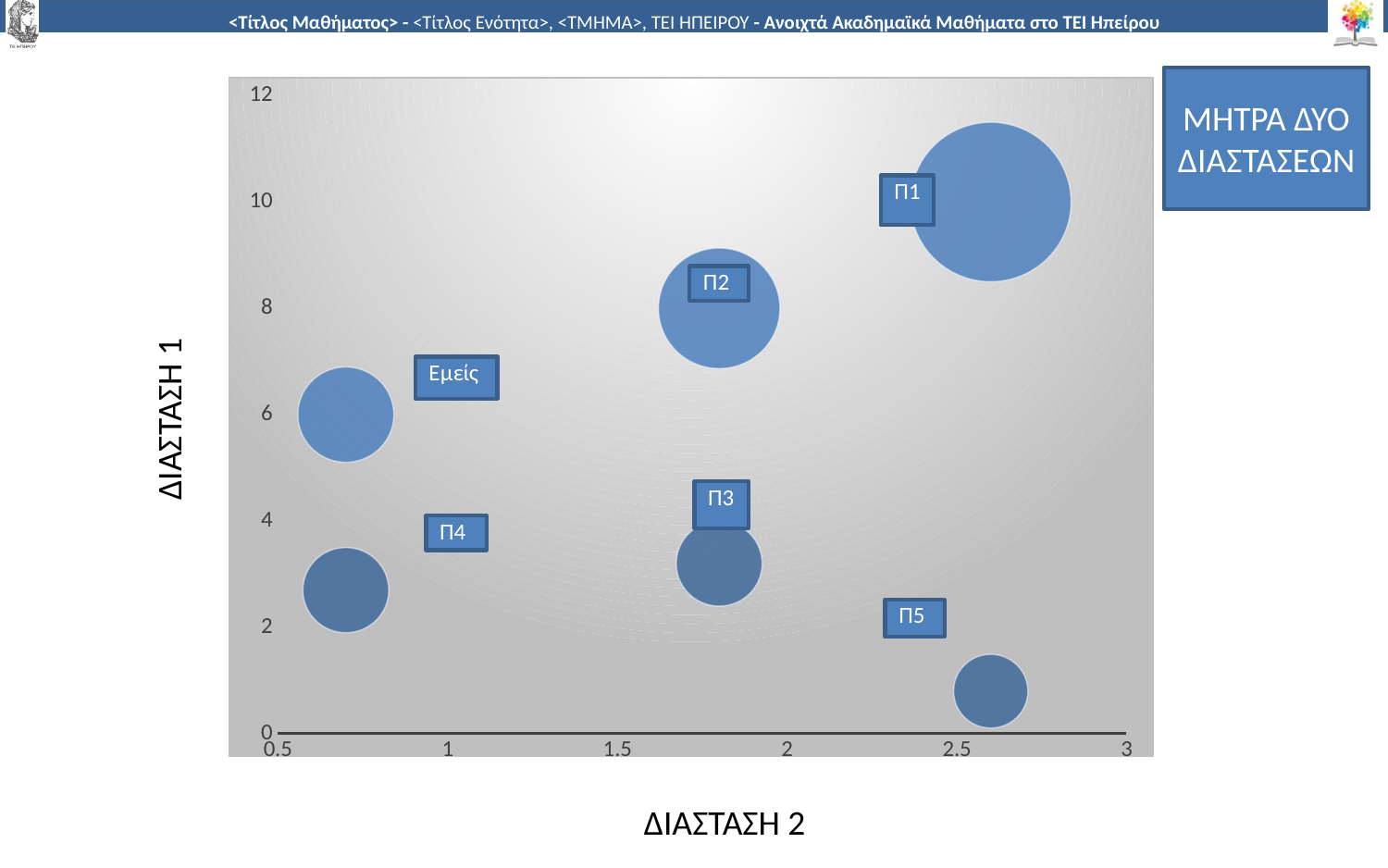
Which bubble has the highest value on the ΔΙΑΣΤΑΣΗ 1 axis? Π1 Which bubble has the lowest value on the ΔΙΑΣΤΑΣΗ 1 axis? Π5 What kind of chart is shown on the slide? Bubble chart Which has the higher ΔΙΑΣΤΑΣΗ 1 value, Π2 or Π3? Π2 What is the title of the vertical axis? ΔΙΑΣΤΑΣΗ 1 Is the ΔΙΑΣΤΑΣΗ 1 value for Εμείς greater or less than 4? greater How many bubbles are plotted on the chart? 6 Which has the higher ΔΙΑΣΤΑΣΗ 2 value, Π1 or Εμείς? Π1 Is the ΔΙΑΣΤΑΣΗ 1 value for Π4 greater or less than 4? less Is the ΔΙΑΣΤΑΣΗ 2 value for Π1 greater or less than 2? greater Which bubble is the largest in size on the chart? Π1